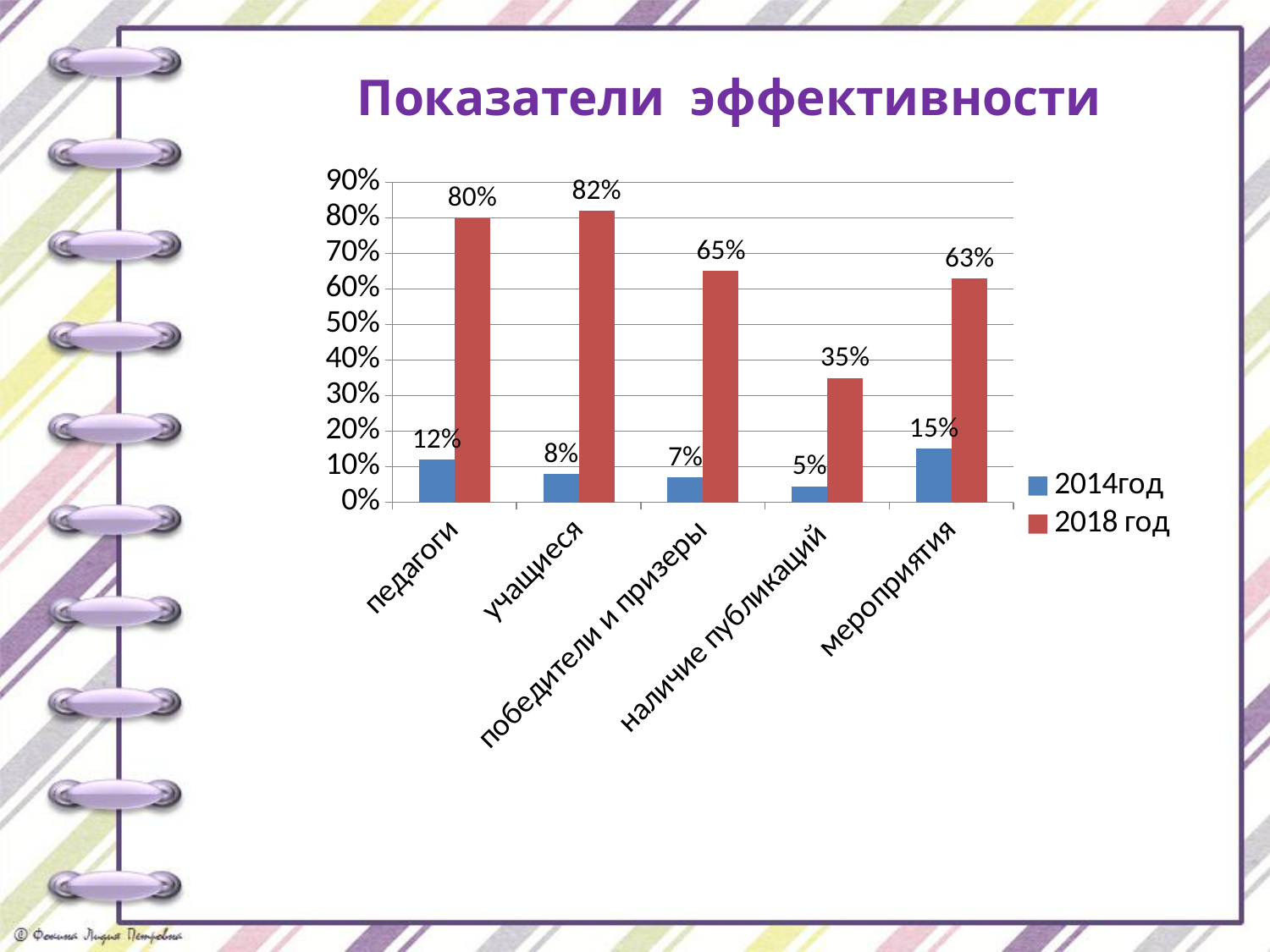
Which category has the lowest value in the 2014год series? наличие публикаций What is the value for мероприятия in the 2014год series? 15% How many series does the legend list? 2 What is the value for учащиеся in the 2014год series? 8% Which category has the highest value in the 2018 год series? учащиеся What kind of chart is shown on the slide? bar chart What is the value for наличие публикаций in the 2018 год series? 35% What is the difference between the 2018 год and 2014год values for победители и призеры? 58% How many categories are shown on the x axis? 5 Which is larger: the 2018 год value for педагоги or the 2018 год value for мероприятия? педагоги What is the value for педагоги in the 2018 год series? 80% What is the title of the slide? Показатели эффективности